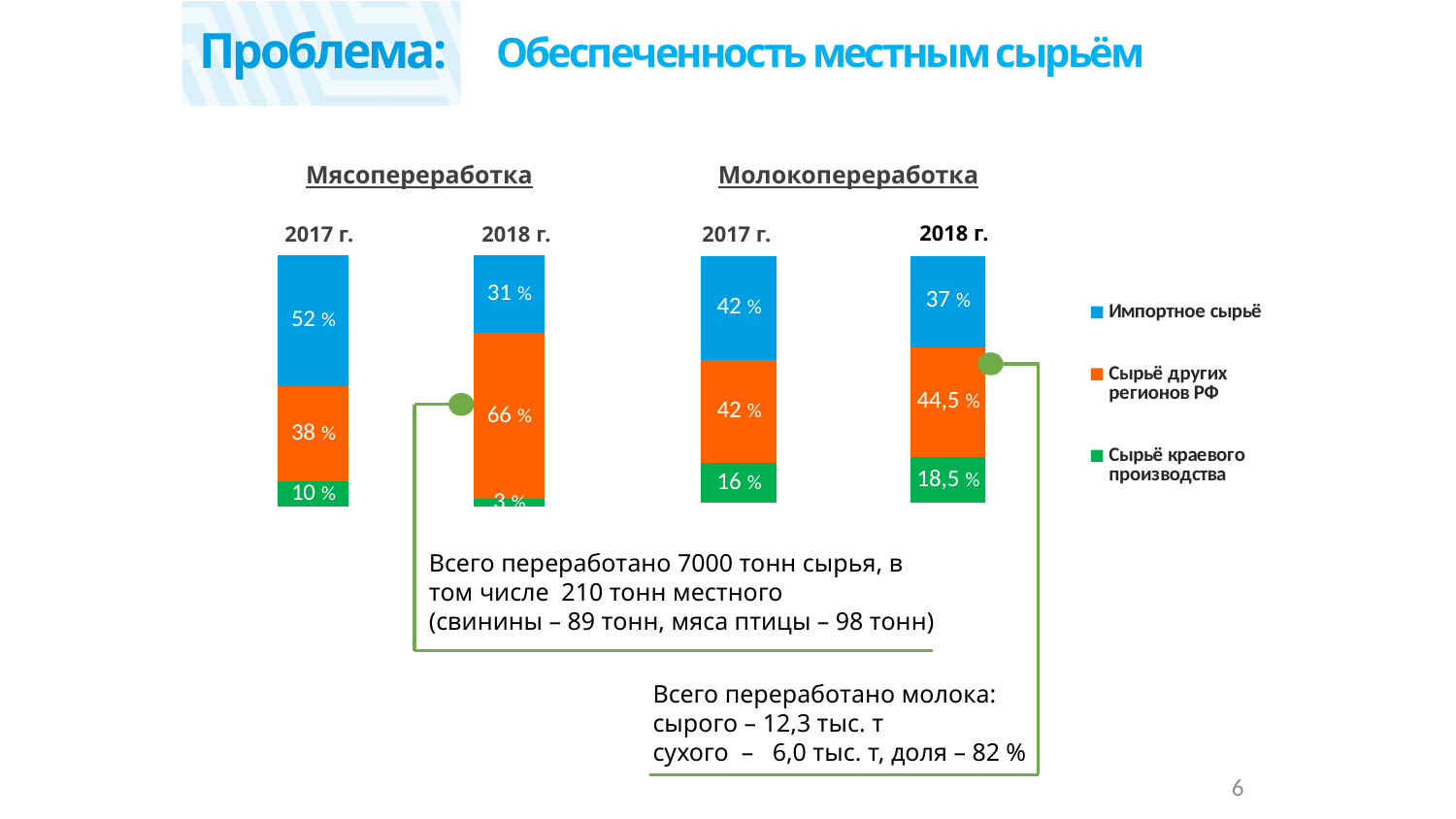
In the Мясопереработка chart, which segment is the smallest in the 2017 г. bar? Сырьё краевого производства Which colour represents Импортное сырьё in the legend? Blue In the Молокопереработка chart, is the share of Сырьё краевого производства larger in 2017 г. or in 2018 г.? 2018 г. How many series does the legend list? 3 In the Мясопереработка chart, what is the share of Сырьё других регионов РФ in 2018 г.? 66 % In the Мясопереработка chart, what is the share of Импортное сырьё in 2017 г.? 52 % In the Молокопереработка chart, what is the share of Сырьё краевого производства in 2018 г.? 18,5 % In the Молокопереработка chart, what is the share of Импортное сырьё in 2017 г.? 42 % In the Мясопереработка chart, which segment is the largest in the 2018 г. bar? Сырьё других регионов РФ What kind of chart is used on the slide? Stacked bar chart In the Мясопереработка chart, what is the difference between the Импортное сырьё share in 2017 г. and in 2018 г.? 21 % In the Молокопереработка chart, what is the share of Сырьё других регионов РФ in 2018 г.? 44,5 %